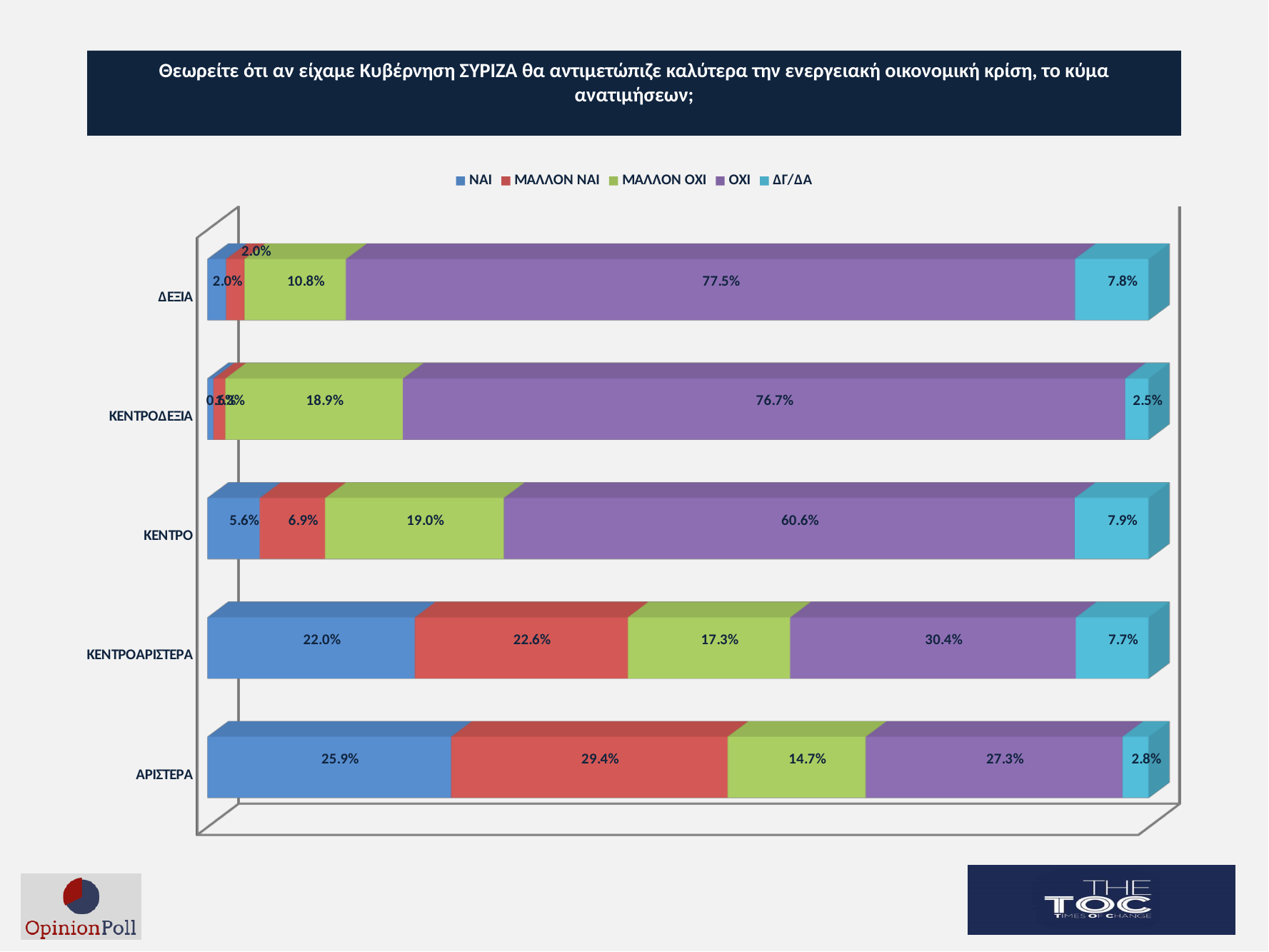
Which category has the highest ΟΧΙ value? ΔΕΞΙΑ How many series does the legend list? 5 What is the ΜΑΛΛΟΝ ΟΧΙ value for ΚΕΝΤΡΟΔΕΞΙΑ? 18.9% Which category has the lowest ΟΧΙ value? ΑΡΙΣΤΕΡΑ What is the ΟΧΙ value for ΔΕΞΙΑ? 77.5% What is the ΔΓ/ΔΑ value for ΚΕΝΤΡΟ? 7.9% Which is larger for ΚΕΝΤΡΟΑΡΙΣΤΕΡΑ: the ΝΑΙ value or the ΟΧΙ value? ΟΧΙ How many categories are shown on the chart? 5 What is the ΜΑΛΛΟΝ ΝΑΙ value for ΑΡΙΣΤΕΡΑ? 29.4% What kind of chart is shown on the slide? Stacked bar chart Which series is shown in purple in the legend? ΟΧΙ What is the difference between the ΝΑΙ values for ΑΡΙΣΤΕΡΑ and ΚΕΝΤΡΟΑΡΙΣΤΕΡΑ? 3.9%